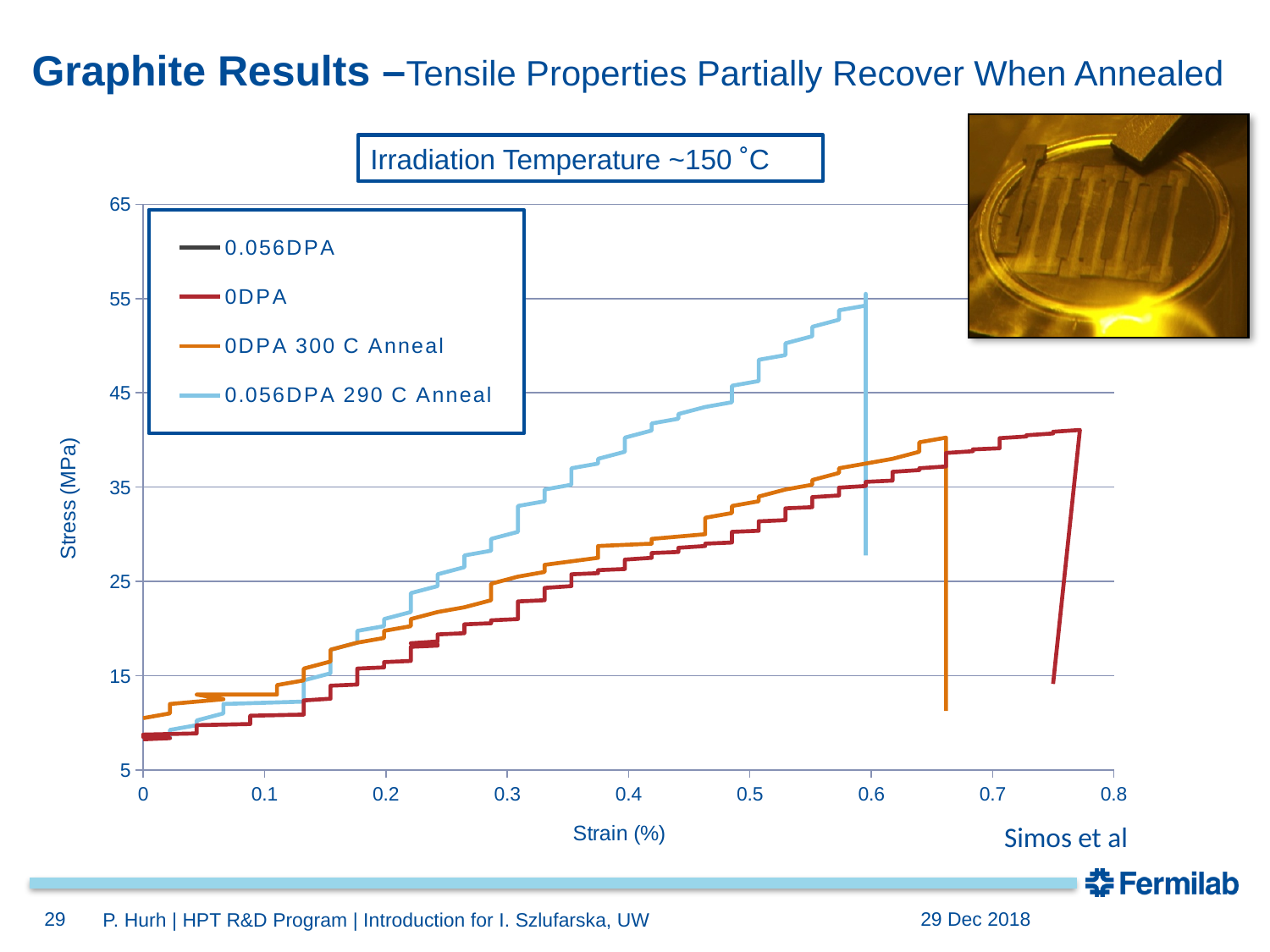
Is the maximum stress reached by the 0DPA 300 C Anneal curve greater or less than 35 MPa? greater Is the strain at which the 0.056DPA 290 C Anneal curve drops off greater or less than 0.7%? less Which series reaches a larger strain before dropping off, 0DPA or 0.056DPA 290 C Anneal? 0DPA Which series reaches a higher maximum stress, 0.056DPA 290 C Anneal or 0DPA? 0.056DPA 290 C Anneal What is the label of the x-axis of the chart? Strain (%) How many series does the chart legend list? 4 What is the label of the y-axis of the chart? Stress (MPa) Is the strain at which the 0DPA curve drops off greater or less than 0.7%? greater Does stress rise or fall as strain increases along the 0DPA curve before it drops off? Rises What kind of chart is shown on the slide? Line chart